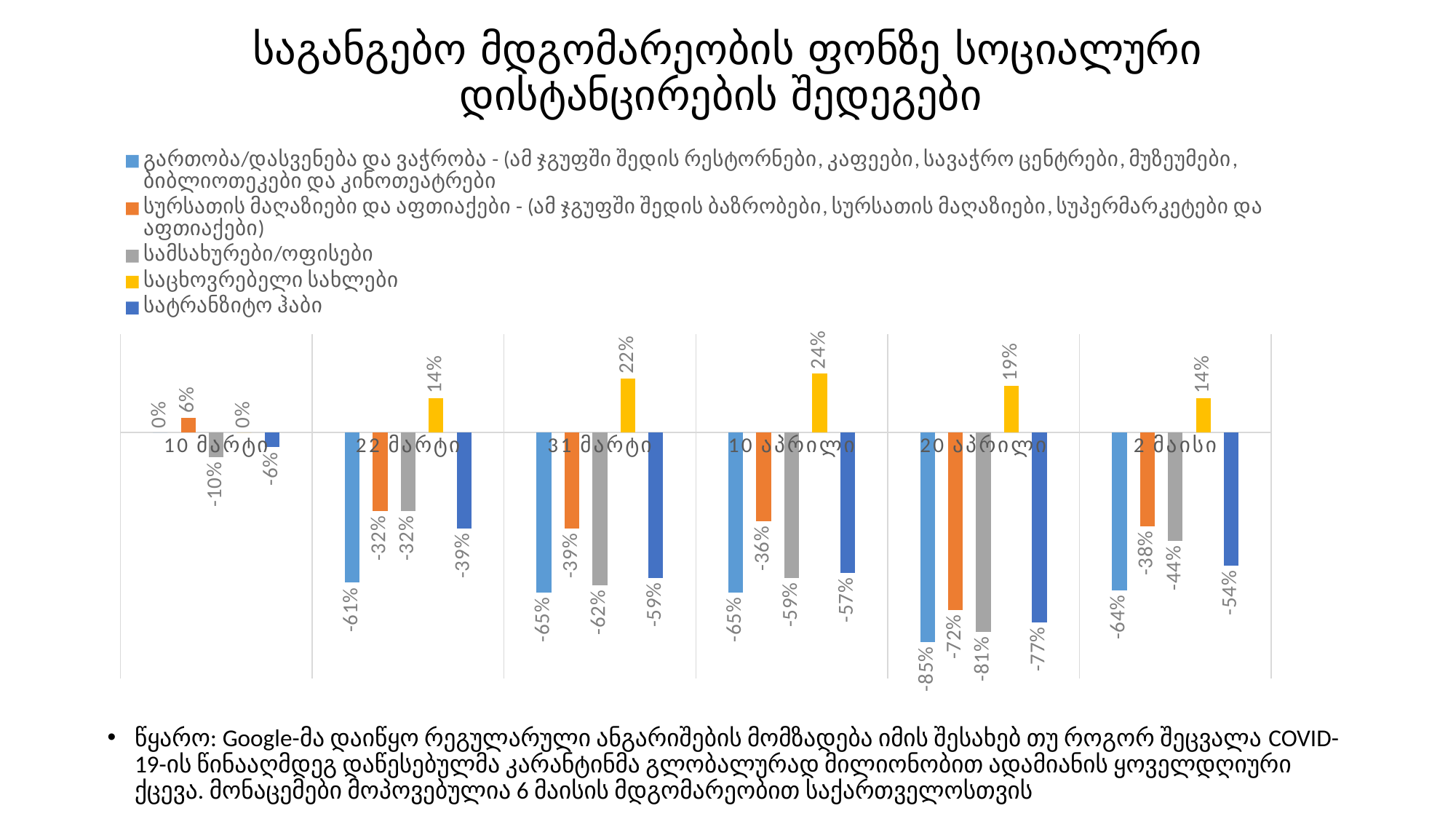
On which date does საცხოვრებელი სახლები reach its highest value? 10 აპრილი What type of chart is shown on the slide? bar chart Which series is shown in yellow in the legend? საცხოვრებელი სახლები On which date does გართობა/დასვენება და ვაჭრობა have its lowest value? 20 აპრილი What is the value for სატრანზიტო ჰაბი on 20 აპრილი? -77% What is the value for საცხოვრებელი სახლები on 10 აპრილი? 24% What is the value for სამსახურები/ოფისები on 2 მაისი? -44% What is the difference between the სამსახურები/ოფისები values on 20 აპრილი and 2 მაისი? 37 percentage points How many series does the legend list? 5 How many date categories are shown on the x axis? 6 What is the value for სურსათის მაღაზიები და აფთიაქები on 10 მარტი? 6% Which is larger on 31 მარტი: the value for სურსათის მაღაზიები და აფთიაქები or the value for სატრანზიტო ჰაბი? სურსათის მაღაზიები და აფთიაქები